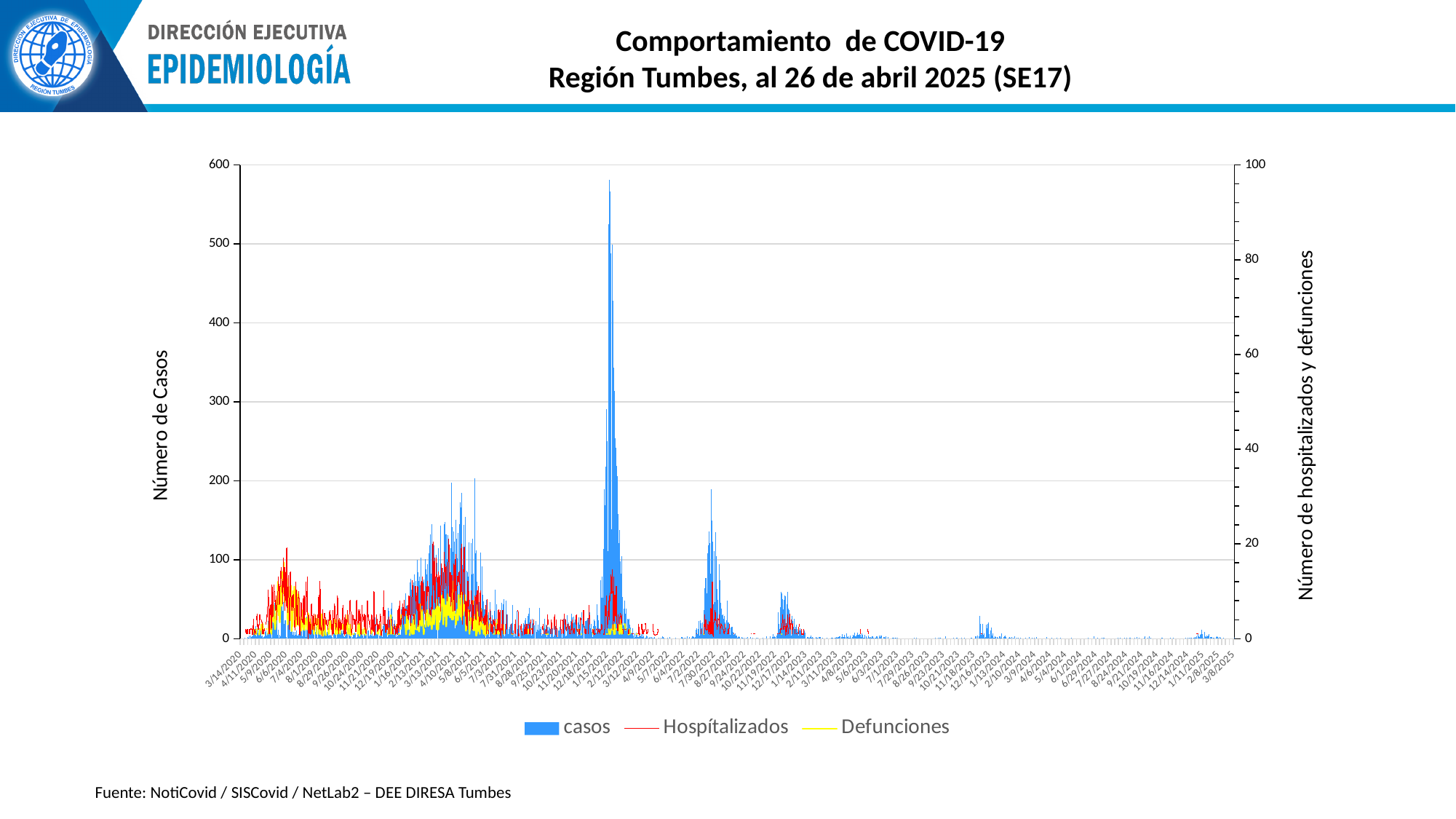
What is the maximum value shown on the right vertical axis? 100 Is the highest peak of the casos series greater or less than 500? greater What is the label of the right vertical axis? Número de hospitalizados y defunciones What is the maximum value shown on the left vertical axis? 600 How many series does the legend list? 3 In which year does the casos series reach its highest peak? 2022 Do the casos values generally rise or fall from the early 2022 peak to the end of the x axis in 2025? fall